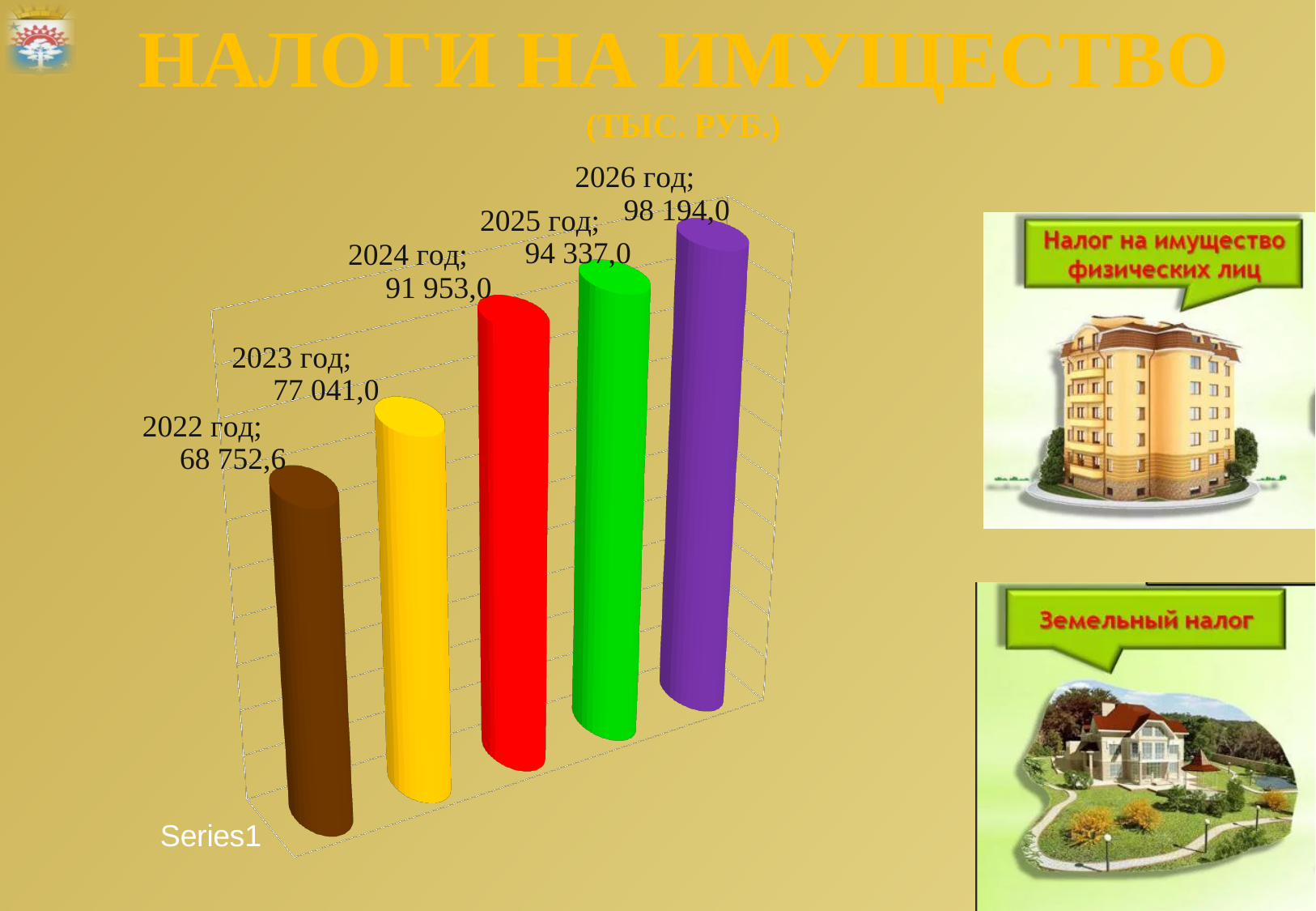
Do the values rise or fall from 2022 год to 2026 год? Rise What kind of chart is shown on the slide? Bar chart Which is larger, the value for 2023 год or the value for 2025 год? 2025 год What is the difference between the values for 2024 год and 2023 год? 14 912,0 What is the value for 2026 год? 98 194,0 Which year has the highest value? 2026 год What is the value for 2022 год? 68 752,6 What unit is given in the chart title? ТЫС. РУБ. Which year has the lowest value? 2022 год What is the difference between the values for 2026 год and 2025 год? 3 857,0 What is the value for 2024 год? 91 953,0 How many bars are shown in the chart? 5